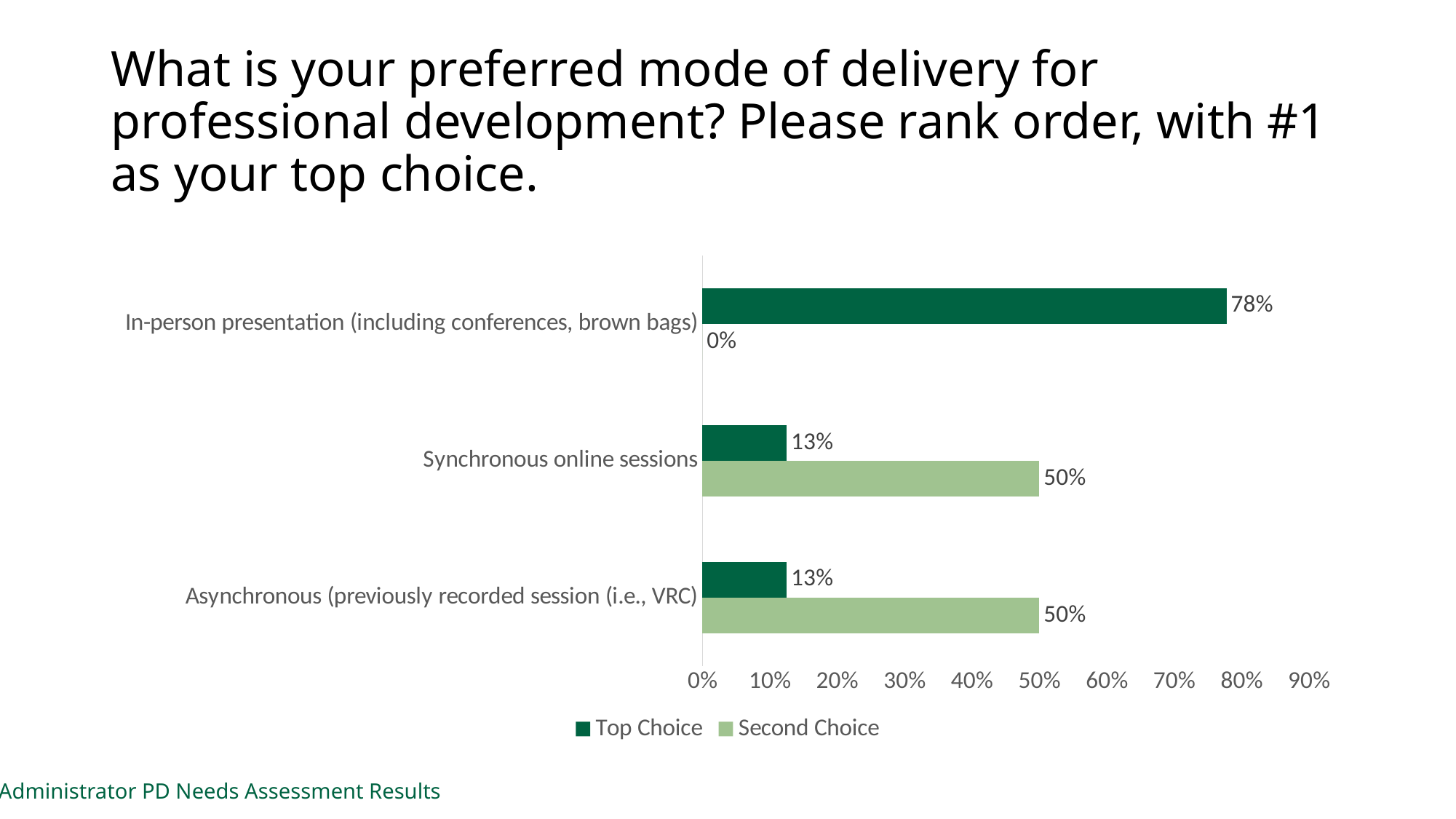
How many series does the legend list? 2 What is the Top Choice value for In-person presentation (including conferences, brown bags)? 78% What are the two series named in the legend? Top Choice and Second Choice What is the Second Choice value for In-person presentation (including conferences, brown bags)? 0% What is the Top Choice value for Asynchronous (previously recorded session (i.e., VRC)? 13% For Synchronous online sessions, which is larger: the Top Choice value or the Second Choice value? Second Choice What is the difference between the Top Choice value for In-person presentation and the Top Choice value for Synchronous online sessions? 65% What is the Second Choice value for Synchronous online sessions? 50% How many categories are shown on the chart? 3 Which category has the lowest Second Choice value? In-person presentation (including conferences, brown bags) Which category has the highest Top Choice value? In-person presentation (including conferences, brown bags) What kind of chart is shown on the slide? Bar chart